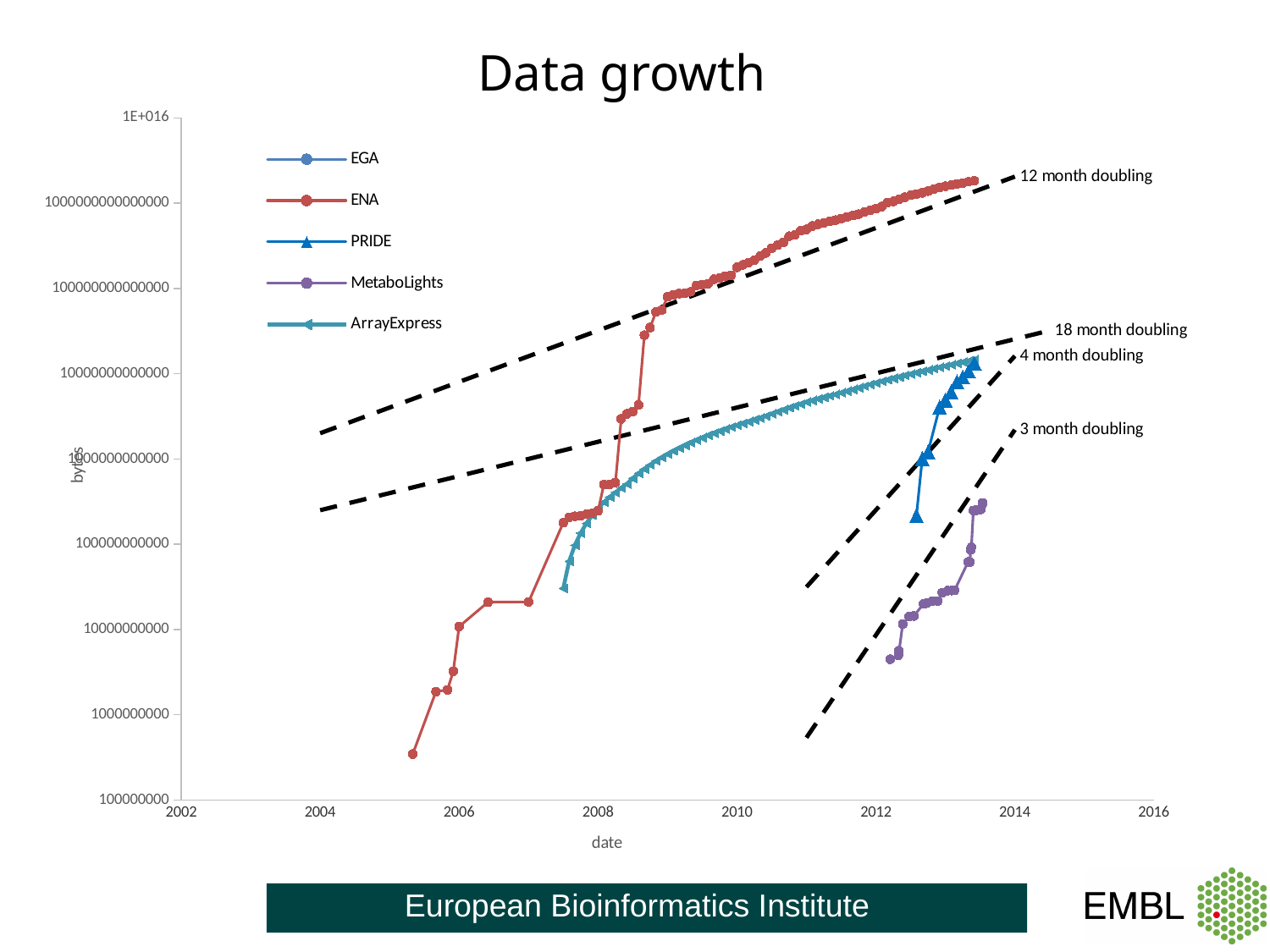
Is the earliest value for ENA greater or less than 1000000000? less How many series does the legend list? 5 Around 2012, which series has the larger value, ENA or ArrayExpress? ENA Which series reaches the highest value on the chart? ENA Do the values for ENA rise or fall over time along the x axis? rise What is the label of the y axis? bytes Is the earliest value for MetaboLights greater or less than 10000000000? less Is the latest value for ENA greater or less than 1000000000000000? greater What kind of chart is shown on the slide? line chart Which series has the lowest plotted value on the chart? ENA Around 2013, which series has the larger value, PRIDE or MetaboLights? PRIDE